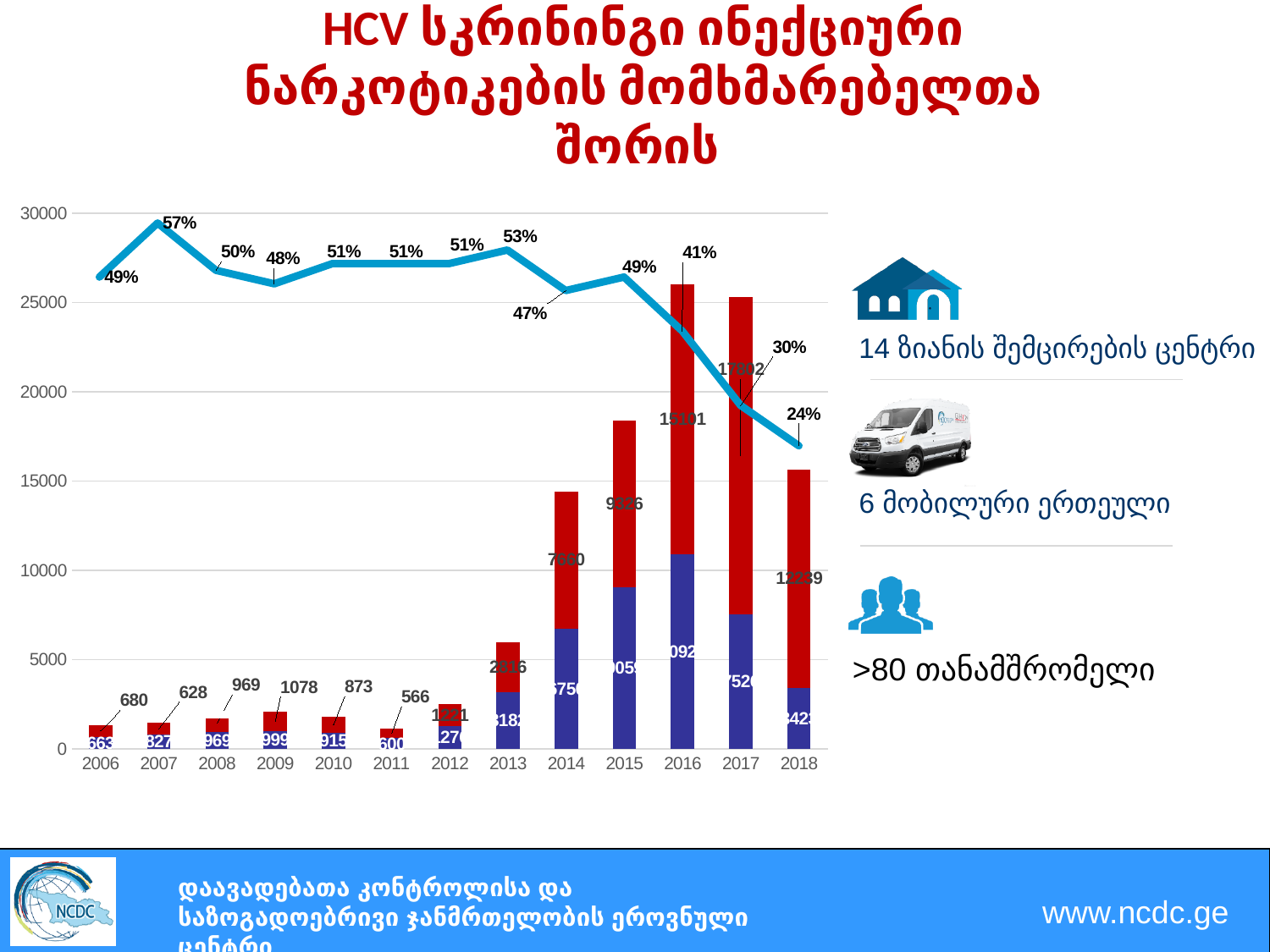
In which year does the line reach its highest percentage? 2007 What kind of chart is shown on the slide? A stacked bar chart combined with a line chart Which year has the taller stacked bar, 2016 or 2017? 2016 What is the value labelled on the red segment of the 2009 bar? 1078 What percentage is shown on the line for 2012? 51% What is the value labelled on the blue segment of the 2006 bar? 663 Is the total height of the 2014 bar greater or less than 10000? greater What is the lowest percentage shown on the line, and in which year? 24% in 2018 How many years are shown on the x axis of the chart? 13 What percentage is shown on the line for 2007? 57% What is the difference between the red segment labels for 2009 (1078) and 2008 (969)? 109 Does the percentage line rise or fall from 2016 to 2018? It falls